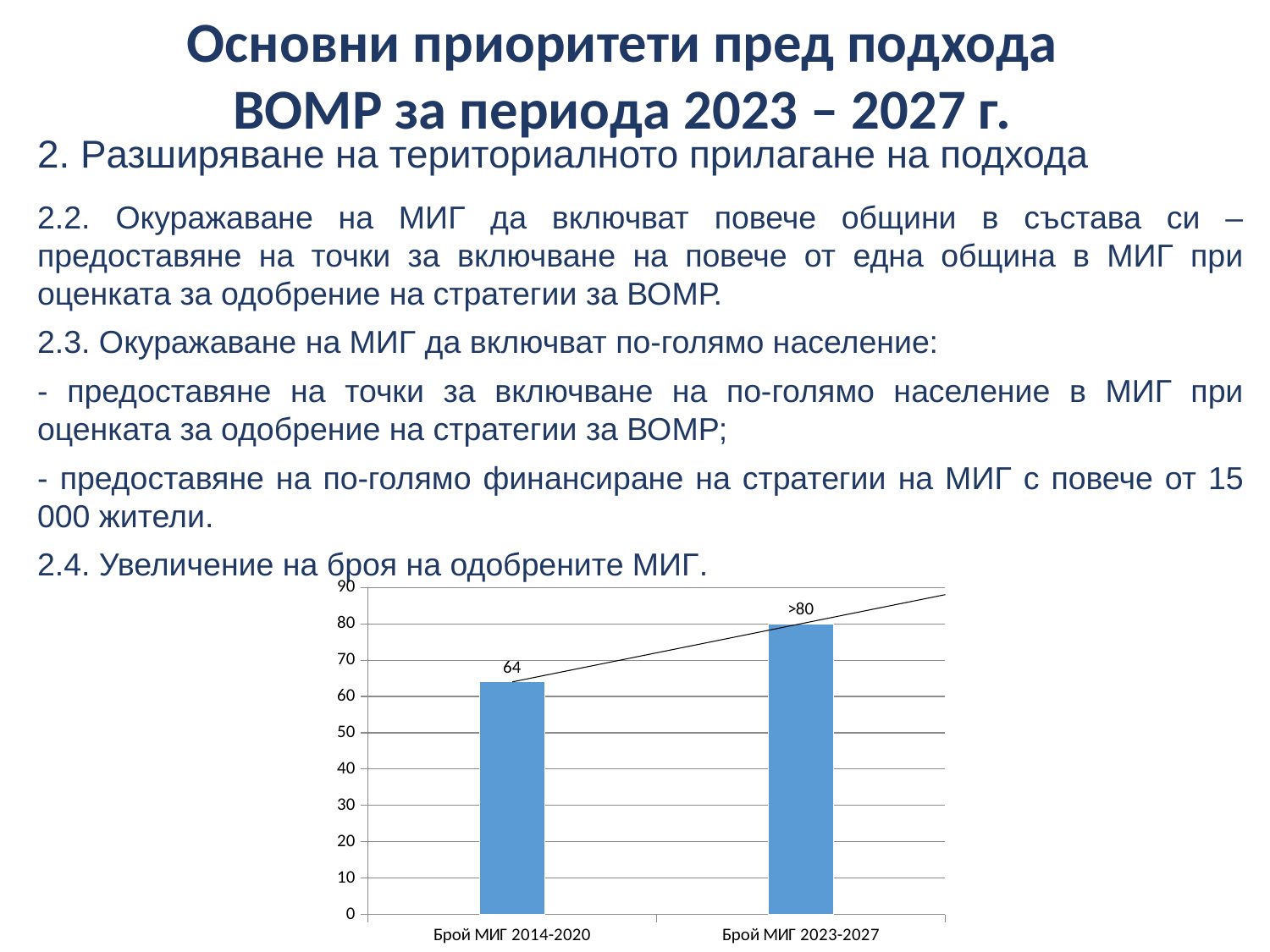
How many categories are shown on the x axis of the chart? 2 Which category has the higher bar? Брой МИГ 2023-2027 What kind of chart is shown on the slide? bar chart What data label is shown for Брой МИГ 2023-2027? >80 Is the value for Брой МИГ 2023-2027 greater or less than 70? greater What colour are the bars in the chart? blue What is the value shown for Брой МИГ 2014-2020? 64 Do the values rise or fall from Брой МИГ 2014-2020 to Брой МИГ 2023-2027? rise What is the highest value shown on the vertical axis of the chart? 90 Is the value for Брой МИГ 2014-2020 greater or less than 70? less Which is larger, the value for Брой МИГ 2014-2020 or for Брой МИГ 2023-2027? Брой МИГ 2023-2027 Which category has the lower bar? Брой МИГ 2014-2020